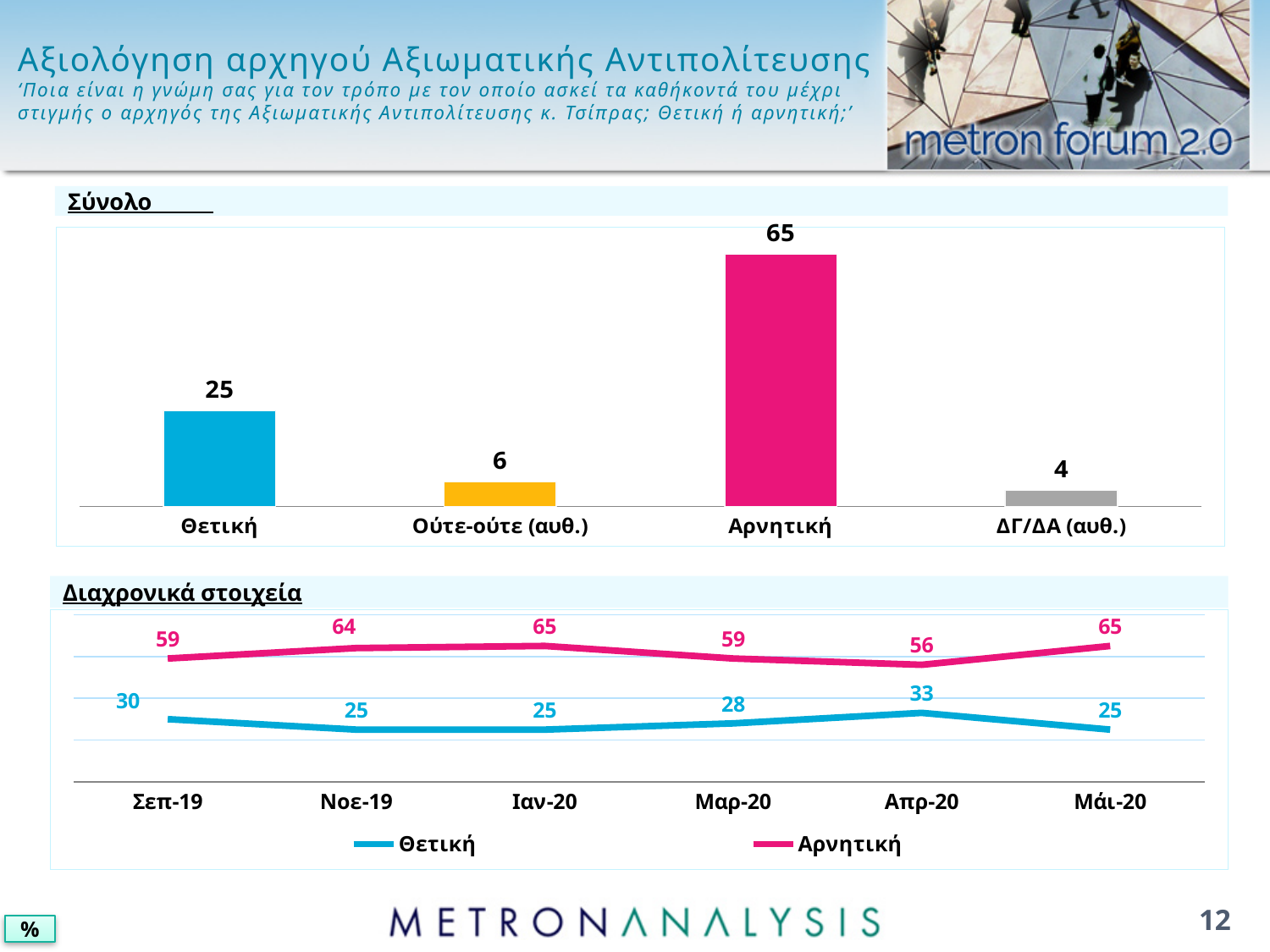
In the 'Σύνολο' bar chart, what is the value for Αρνητική? 65 In the 'Διαχρονικά στοιχεία' line chart, in which month does Θετική reach its highest value? Απρ-20 In the 'Διαχρονικά στοιχεία' line chart, what is the difference between Αρνητική and Θετική in Μάι-20? 40 In the 'Σύνολο' bar chart, which category has the lowest value? ΔΓ/ΔΑ (αυθ.) In the 'Διαχρονικά στοιχεία' line chart, how many series does the legend list? 2 In the 'Διαχρονικά στοιχεία' line chart, does Αρνητική rise or fall from Απρ-20 to Μάι-20? rise In the 'Σύνολο' bar chart, how many categories are shown? 4 In the 'Σύνολο' bar chart, what is the difference between Αρνητική and Θετική? 40 In the 'Διαχρονικά στοιχεία' line chart, what is the value of Θετική for Σεπ-19? 30 In the 'Σύνολο' bar chart, what is the value for Θετική? 25 In the 'Διαχρονικά στοιχεία' line chart, what is the value of Αρνητική for Απρ-20? 56 What kind of chart is the 'Σύνολο' chart? bar chart